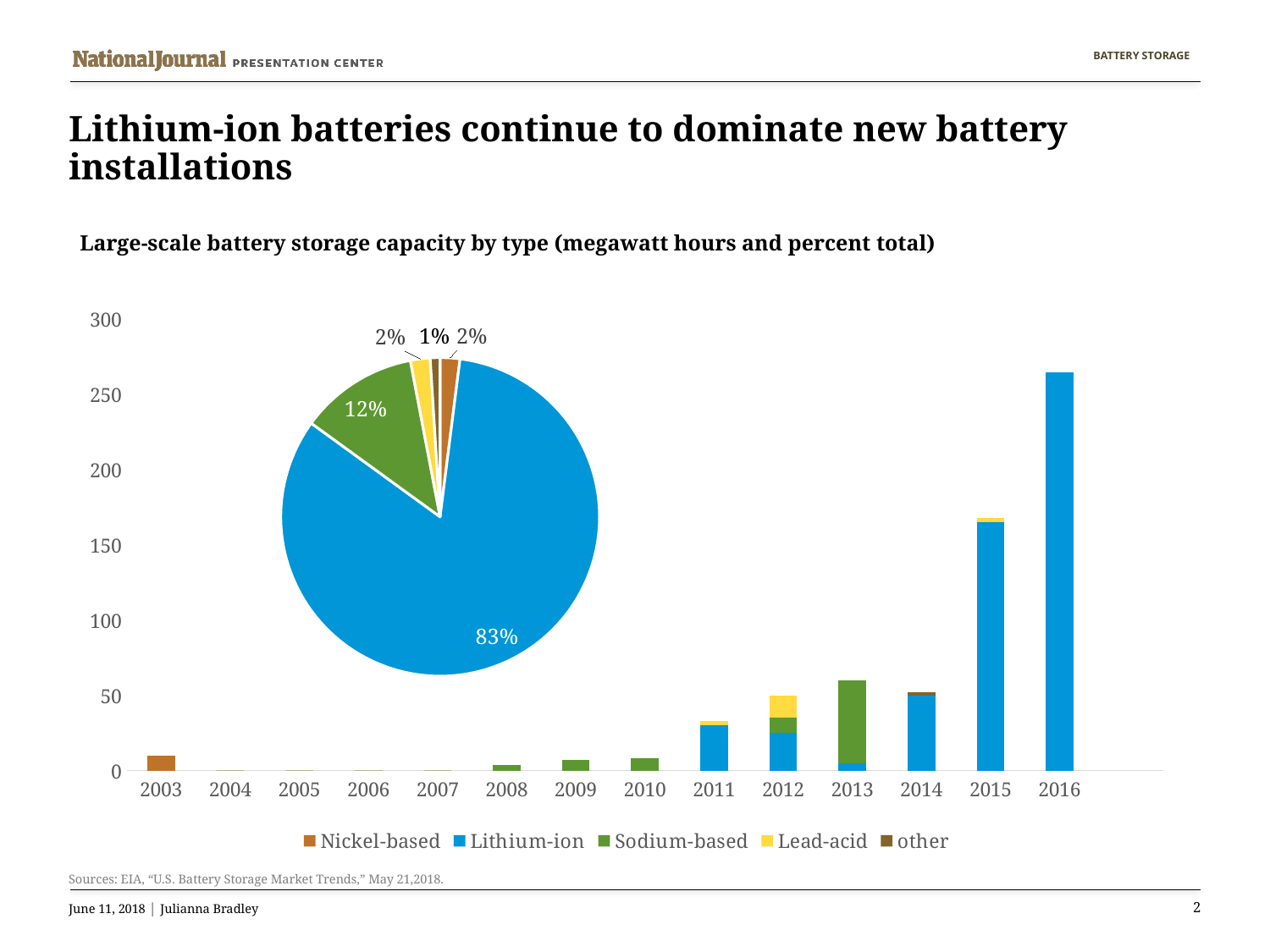
In the bar chart, how many years are shown on the x axis? 14 In the pie chart, what share of total capacity is Sodium-based? 12% In the bar chart, is the total value for 2013 greater or less than 100? less In the pie chart, which battery type has the largest slice? Lithium-ion In the pie chart, what share of total capacity is Lithium-ion? 83% In the bar chart, is the total value for 2016 greater or less than 250? greater How many series does the legend list? 5 In the bar chart, is the total value for 2015 greater or less than 150? greater What is the subtitle describing the chart data? Large-scale battery storage capacity by type (megawatt hours and percent total) In the bar chart, which year has the highest total battery storage capacity? 2016 What kind of chart is the chart showing capacity by year from 2003 to 2016? bar chart In the bar chart, which year has the larger total, 2015 or 2016? 2016